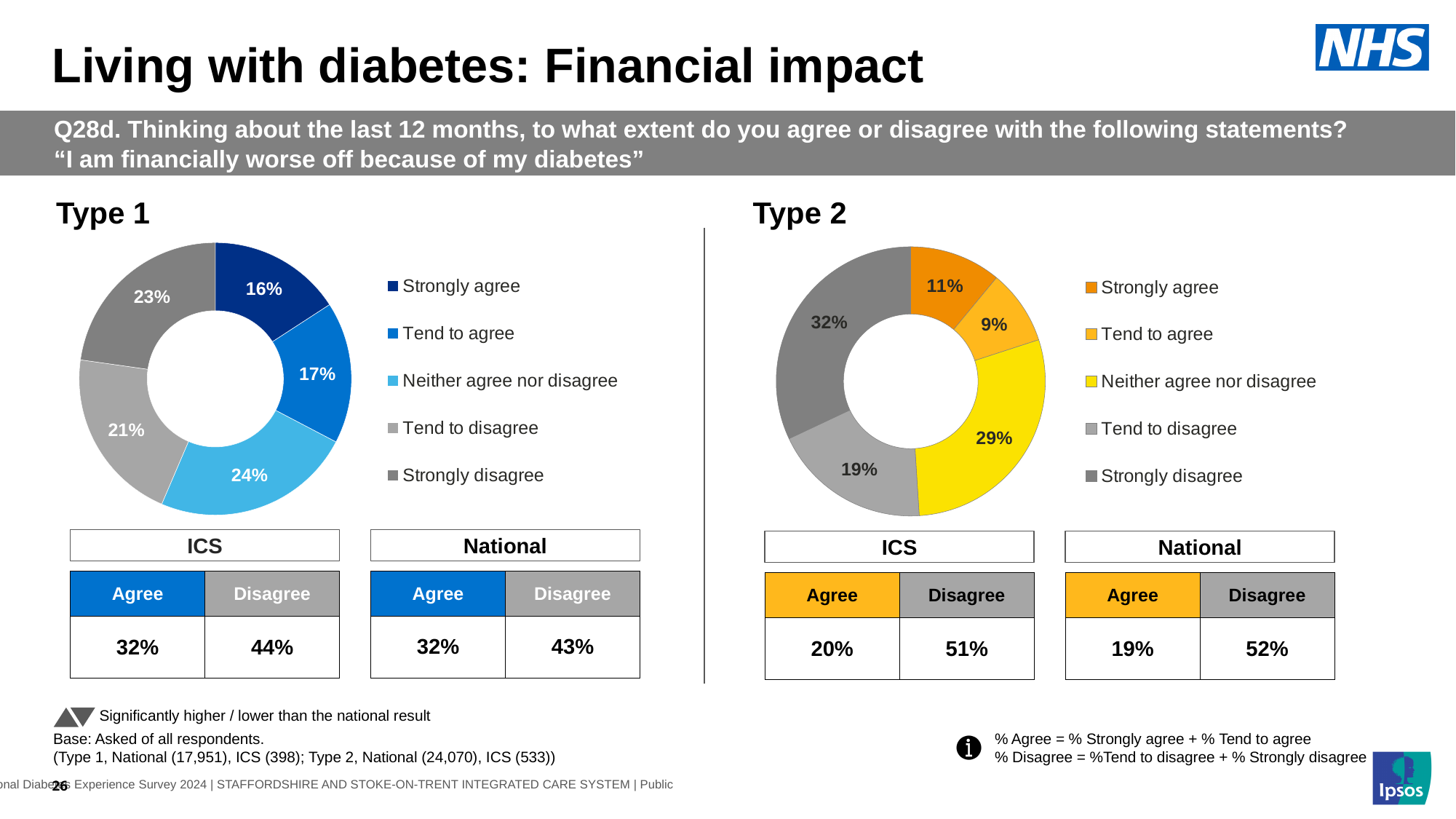
In the Type 1 chart, what percentage of respondents said 'Strongly agree'? 16% In the Type 1 chart, what percentage of respondents said 'Tend to disagree'? 21% In the Type 2 chart, which response category has the largest share? Strongly disagree In the Type 2 chart, what percentage of respondents said 'Neither agree nor disagree'? 29% How many response categories does the legend of the Type 1 chart list? 5 In the Type 1 chart, which response category has the largest share? Neither agree nor disagree In the Type 2 chart, which is larger: the 'Strongly disagree' share or the 'Tend to disagree' share? Strongly disagree In the Type 2 chart, which response category has the smallest share? Tend to agree In the Type 1 chart, what colour is the 'Strongly agree' segment? Dark blue In the Type 2 chart, what is the difference between the 'Strongly disagree' share and the 'Strongly agree' share? 21 percentage points What kind of chart is used to show the Type 2 results? Doughnut (pie) chart In the Type 1 chart, what is the difference between the 'Neither agree nor disagree' share and the 'Strongly agree' share? 8 percentage points